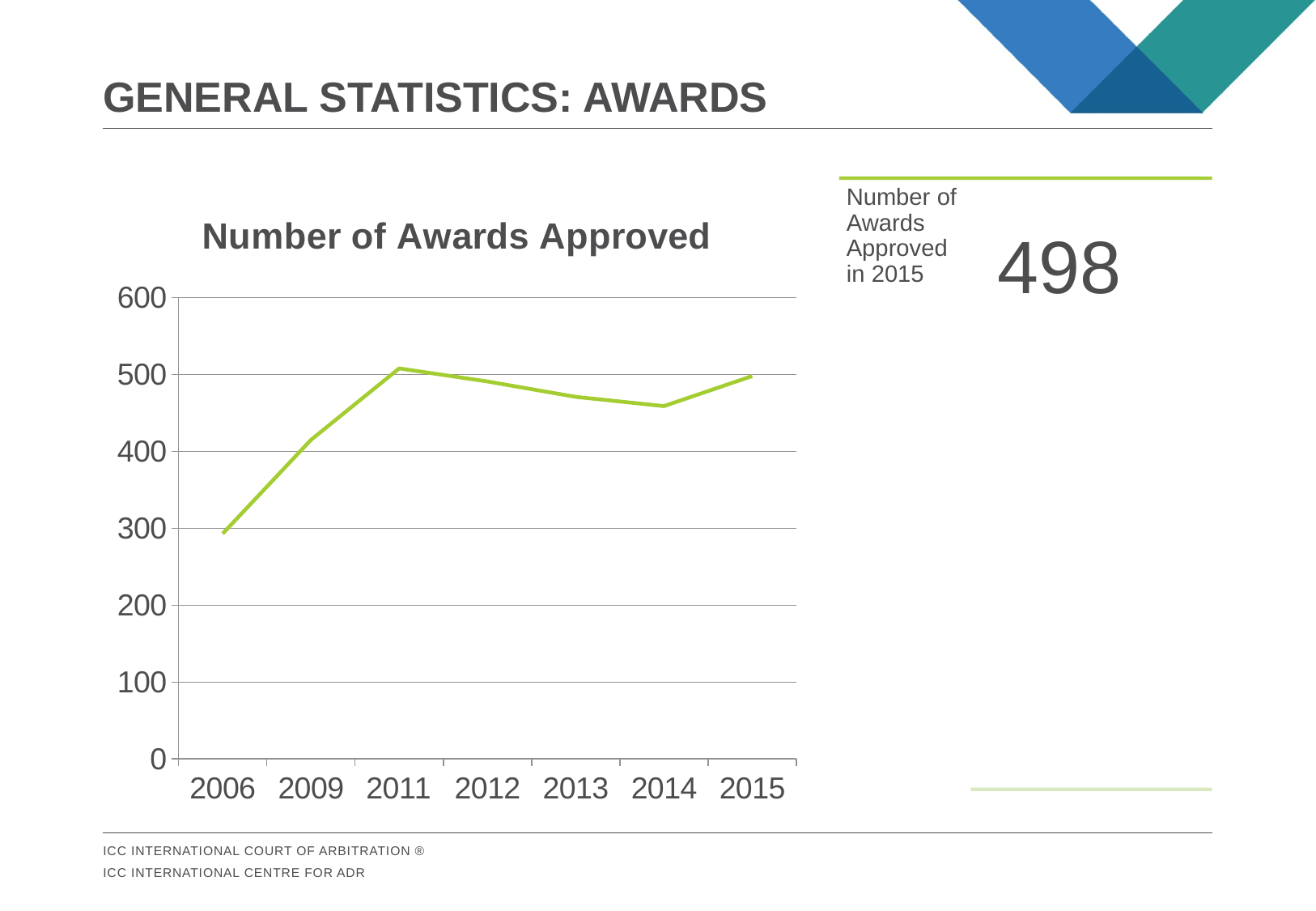
Which year has the larger value, 2009 or 2014? 2014 How many years are plotted on the x axis of the chart? 7 Which year has the lowest number of awards approved? 2006 Do the values rise or fall from 2006 to 2011? rise What is the title of the chart? Number of Awards Approved Is the value for 2014 greater or less than 500? less What is the number of awards approved in 2015? 498 Is the value for 2009 greater or less than 400? greater Is the value for 2006 greater or less than 200? greater What type of chart is shown on the slide? line chart Do the values rise or fall from 2011 to 2014? fall